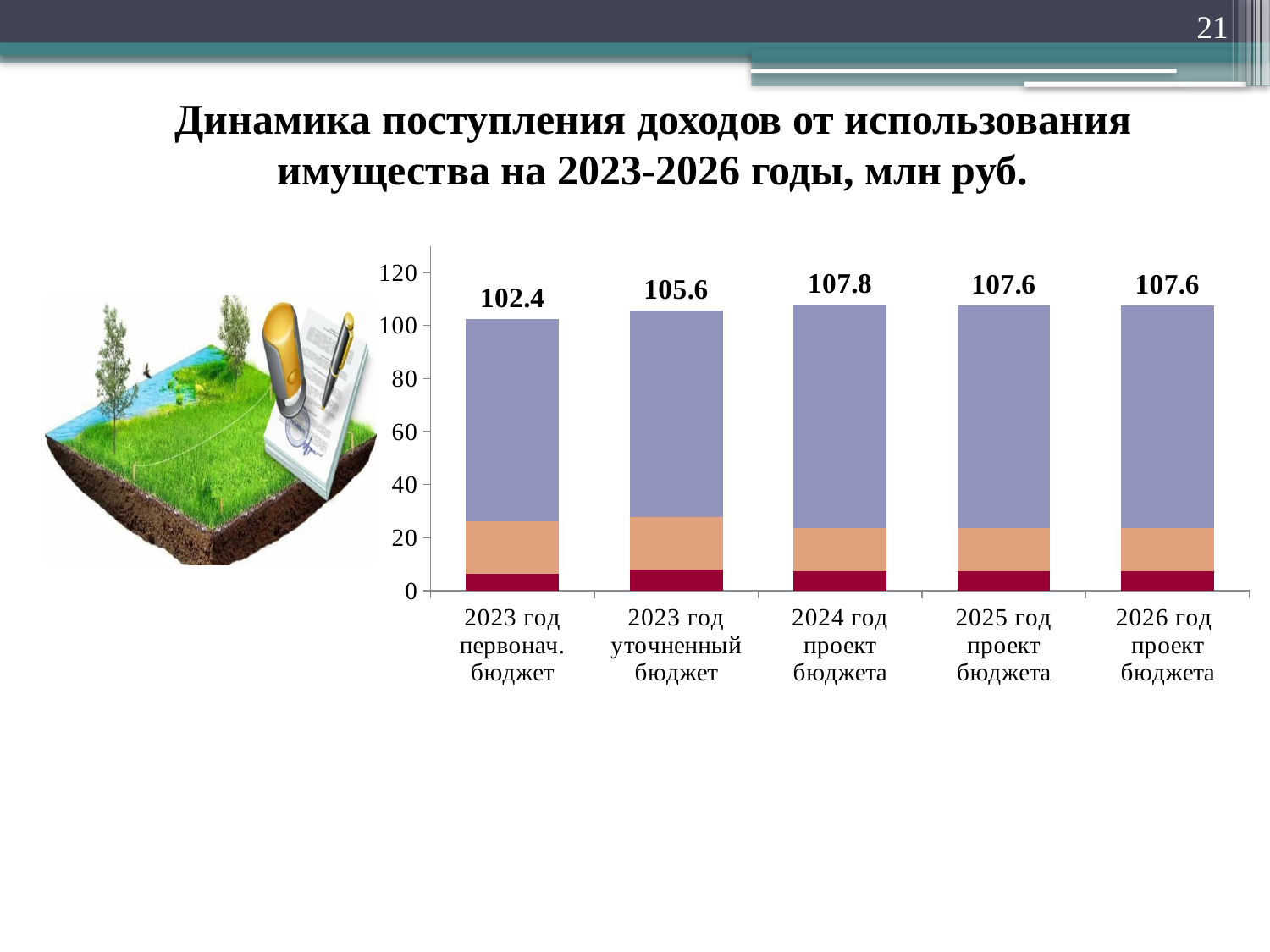
What is the total value labelled for the 2024 год проект бюджета bar? 107.8 How many categories are shown on the x axis? 5 What is the total value labelled for the 2026 год проект бюджета bar? 107.6 What is the total value labelled for the 2023 год уточненный бюджет bar? 105.6 What kind of chart is shown on the slide? stacked bar chart How many coloured segments make up each stacked bar? 3 Which category has the highest labelled total? 2024 год проект бюджета What is the difference between the labelled totals for 2023 год уточненный бюджет and 2023 год первонач. бюджет? 3.2 Which is larger, the labelled total for 2024 год проект бюджета or for 2025 год проект бюджета? 2024 год проект бюджета What is the total value labelled for the 2023 год первонач. бюджет bar? 102.4 Is the total for 2023 год первонач. бюджет greater or less than 100? greater Which category has the lowest labelled total? 2023 год первонач. бюджет